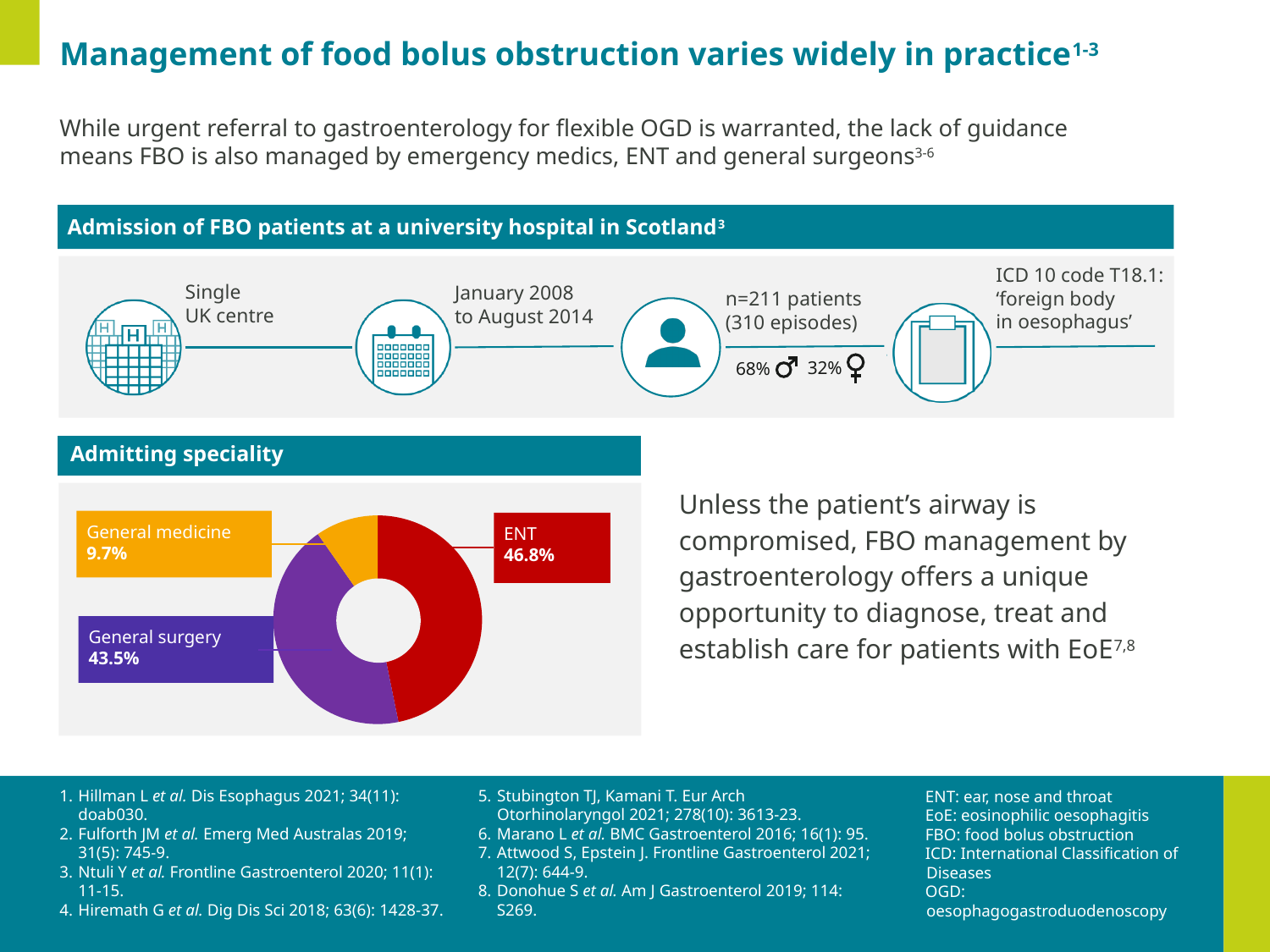
How many admitting specialities are shown in the Admitting speciality chart? 3 Which admitting speciality has the smallest share in the chart? General medicine What share of admissions does General surgery account for in the Admitting speciality chart? 43.5% What kind of chart is used to show the admitting speciality data? Pie chart (donut) In the Admitting speciality chart, which is larger: the share for General surgery or the share for General medicine? General surgery Which admitting speciality has the largest share in the chart? ENT What is the value shown for General medicine in the Admitting speciality chart? 9.7% What percentage of FBO patients were admitted under ENT in the Admitting speciality chart? 46.8% By how many percentage points does the ENT share exceed the General surgery share in the Admitting speciality chart? 3.3 percentage points By how many percentage points does General surgery exceed General medicine in the Admitting speciality chart? 33.8 percentage points What is the title of the chart showing the breakdown of admissions by speciality? Admitting speciality What colour is the ENT slice in the Admitting speciality chart? Red